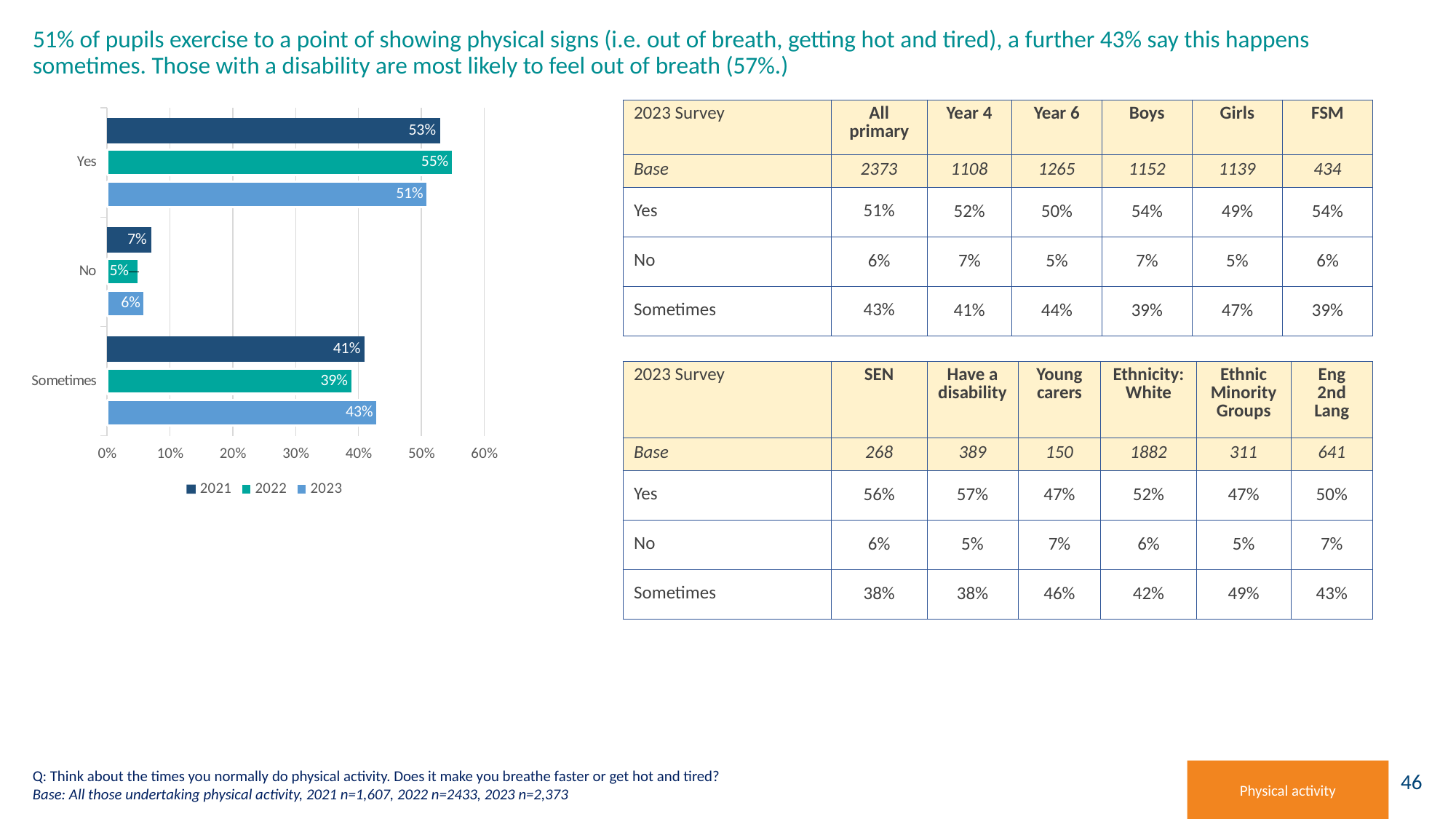
What kind of chart is shown on the slide? bar chart Which series is shown in the darkest blue colour? 2021 What is the difference between the 2022 and 2023 values for 'Yes'? 4% Which is larger: the 2021 value for 'Sometimes' or the 2023 value for 'Sometimes'? 2023 Which year has the highest value for 'Yes'? 2022 How many series does the legend list? 3 How many categories are shown on the chart? 3 What is the value for 'Yes' in the 2023 series? 51% Is the 2021 value for 'Yes' greater or less than 50%? greater What is the value for 'No' in the 2021 series? 7% Which year has the lowest value for 'No'? 2022 What is the value for 'Sometimes' in the 2022 series? 39%